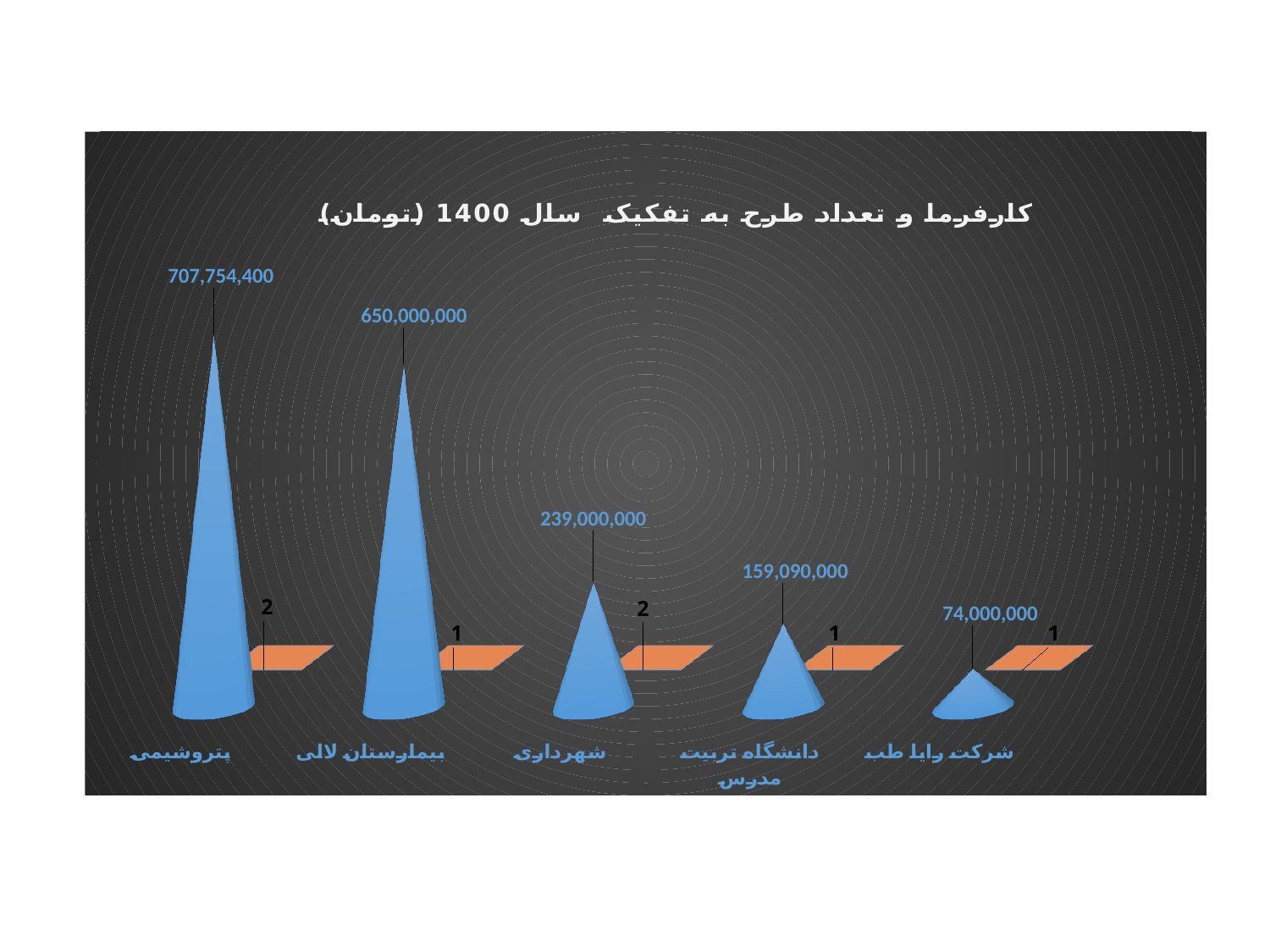
How many projects (the orange series value) are shown for شهرداری? 2 Which category has the lowest blue cone value? شرکت رایا طب What is the value shown for شهرداری (the blue cone)? 239,000,000 What kind of chart is shown on the slide? 3D bar chart (cone-shaped bars) How many categories are shown on the x axis? 5 Which is larger, the blue cone value for شهرداری or for دانشگاه تربیت مدرس? شهرداری What is the value shown for دانشگاه تربیت مدرس (the blue cone)? 159,090,000 Which category has the highest blue cone value? پتروشیمی What is the difference between the blue cone values for پتروشیمی and بیمارستان لالی? 57,754,400 What is the value shown for شرکت رایا طب (the blue cone)? 74,000,000 What is the value shown for پتروشیمی (the blue cone)? 707,754,400 What is the value shown for بیمارستان لالی (the blue cone)? 650,000,000